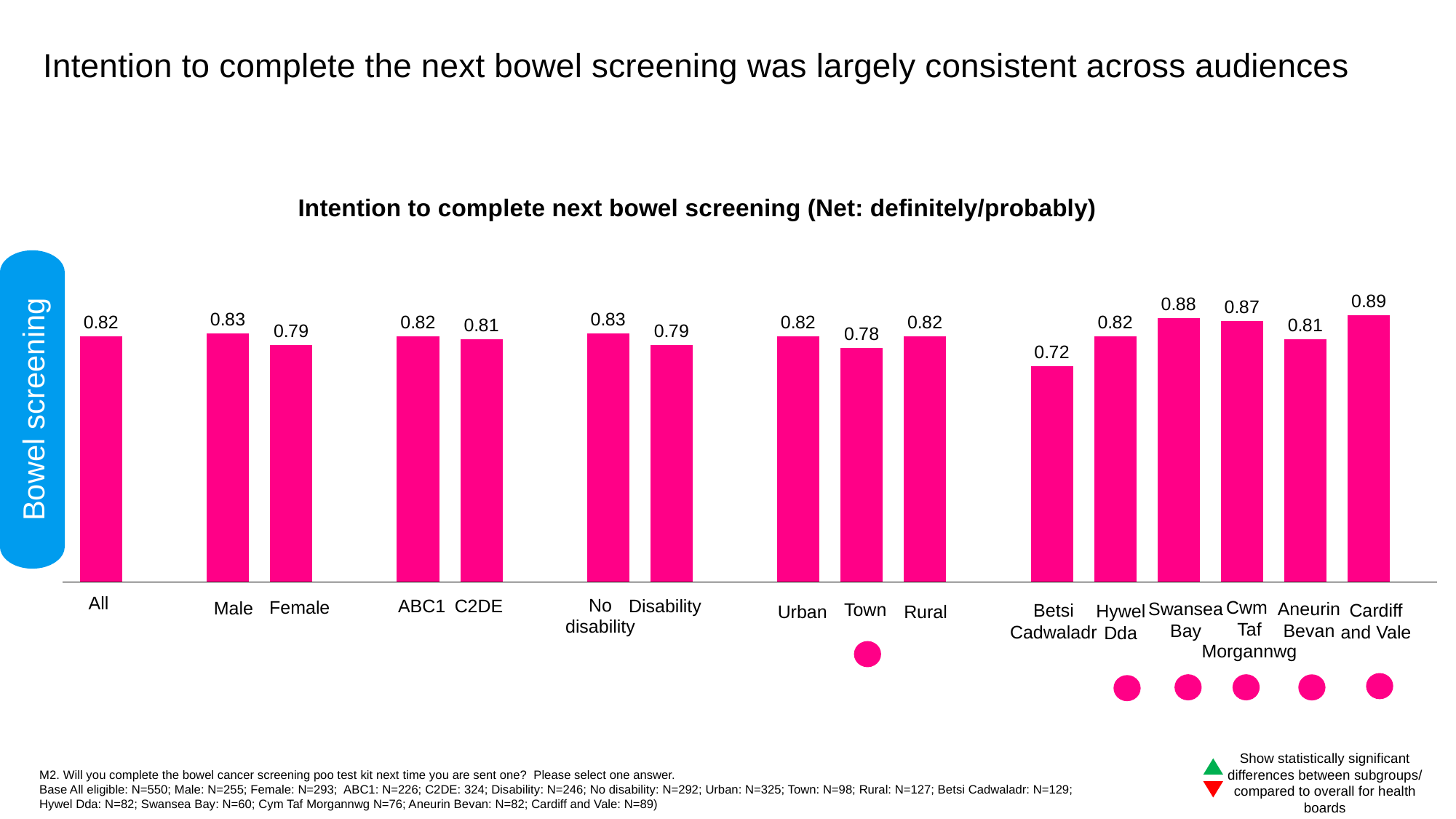
Which category has the lowest value? Betsi Cadwaladr What is the value for Town? 0.78 What is the title of the chart? Intention to complete next bowel screening (Net: definitely/probably) Which is larger, the value for Urban or the value for Town? Urban What kind of chart is shown on the slide? Bar chart What is the difference between the values for Cardiff and Vale and Betsi Cadwaladr? 0.17 Which category has the highest value? Cardiff and Vale What is the value for the All category? 0.82 What is the value for Swansea Bay? 0.88 What is the value for Betsi Cadwaladr? 0.72 How many bars are plotted in the chart? 16 What is the difference between the values for Male and Female? 0.04